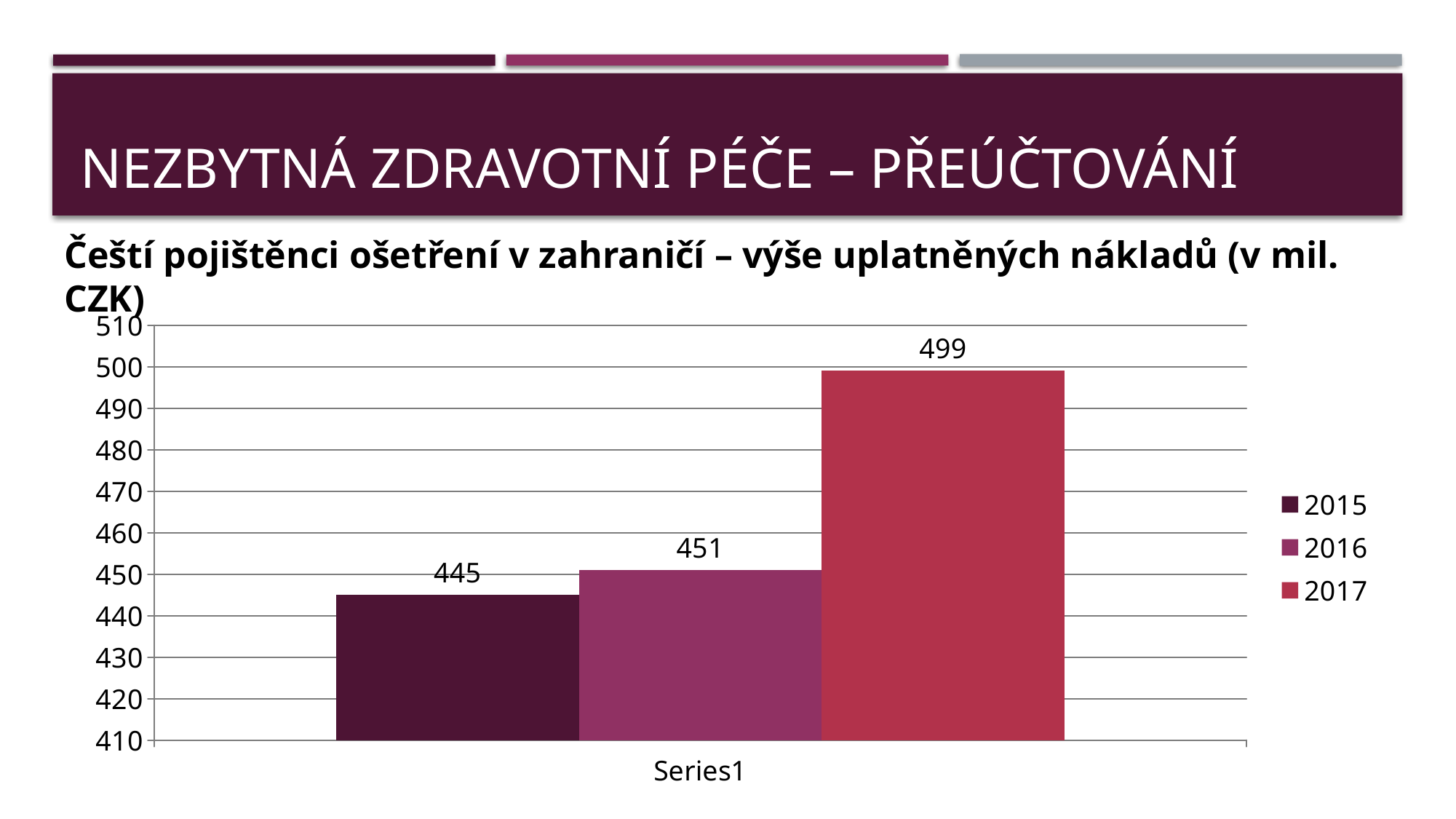
Which year has the lowest value? 2015 Which is larger, the value for 2016 or the value for 2017? 2017 What is the value for 2017? 499 What is the label shown on the x axis under the bars? Series1 What is the difference between the values for 2016 and 2015? 6 How many series does the legend list? 3 What kind of chart is shown? bar chart Do the values rise or fall from 2015 to 2017? rise What is the difference between the values for 2017 and 2015? 54 What is the value for 2016? 451 What is the value for 2015? 445 Which year has the highest value? 2017